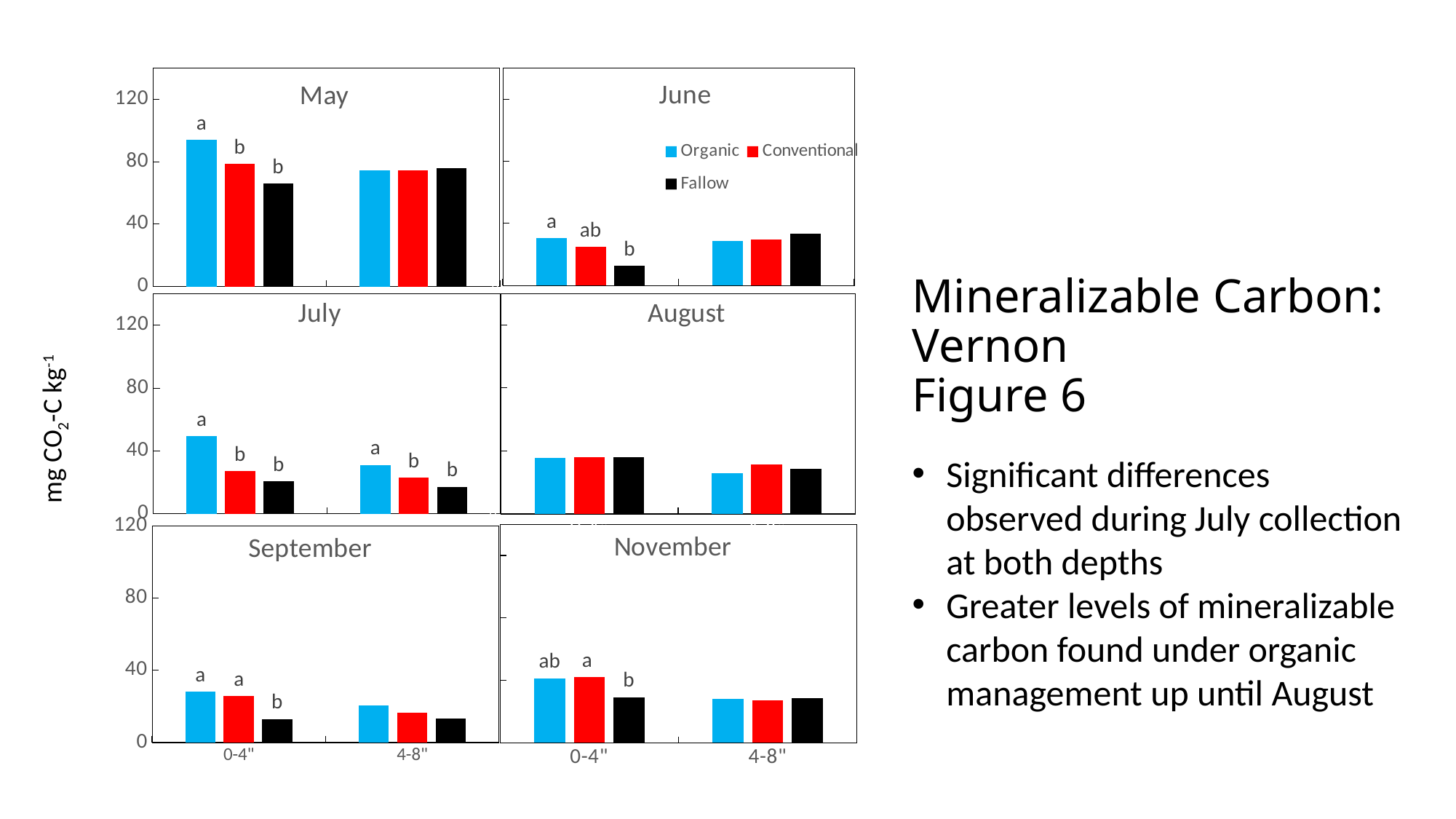
In the September chart, which is larger at 0-4": Organic or Fallow? Organic What kind of chart is used in each of the monthly panels on this slide? bar chart In the May chart, is the value for Organic at 0-4" greater or less than 80? greater In the July chart, is the value for Organic at 0-4" greater or less than 40? greater In the May chart, which series has the highest value at 0-4"? Organic In the July chart, which is larger at 4-8": Organic or Fallow? Organic How many monthly chart panels are shown on the slide? 6 In the June chart, which series has the lowest value at 0-4"? Fallow What are the three series named in the legend? Organic, Conventional, Fallow In the May chart, is the value for Fallow at 0-4" greater or less than 80? less How many depth categories are shown on the x axis of each chart? 2 How many series does the legend list? 3